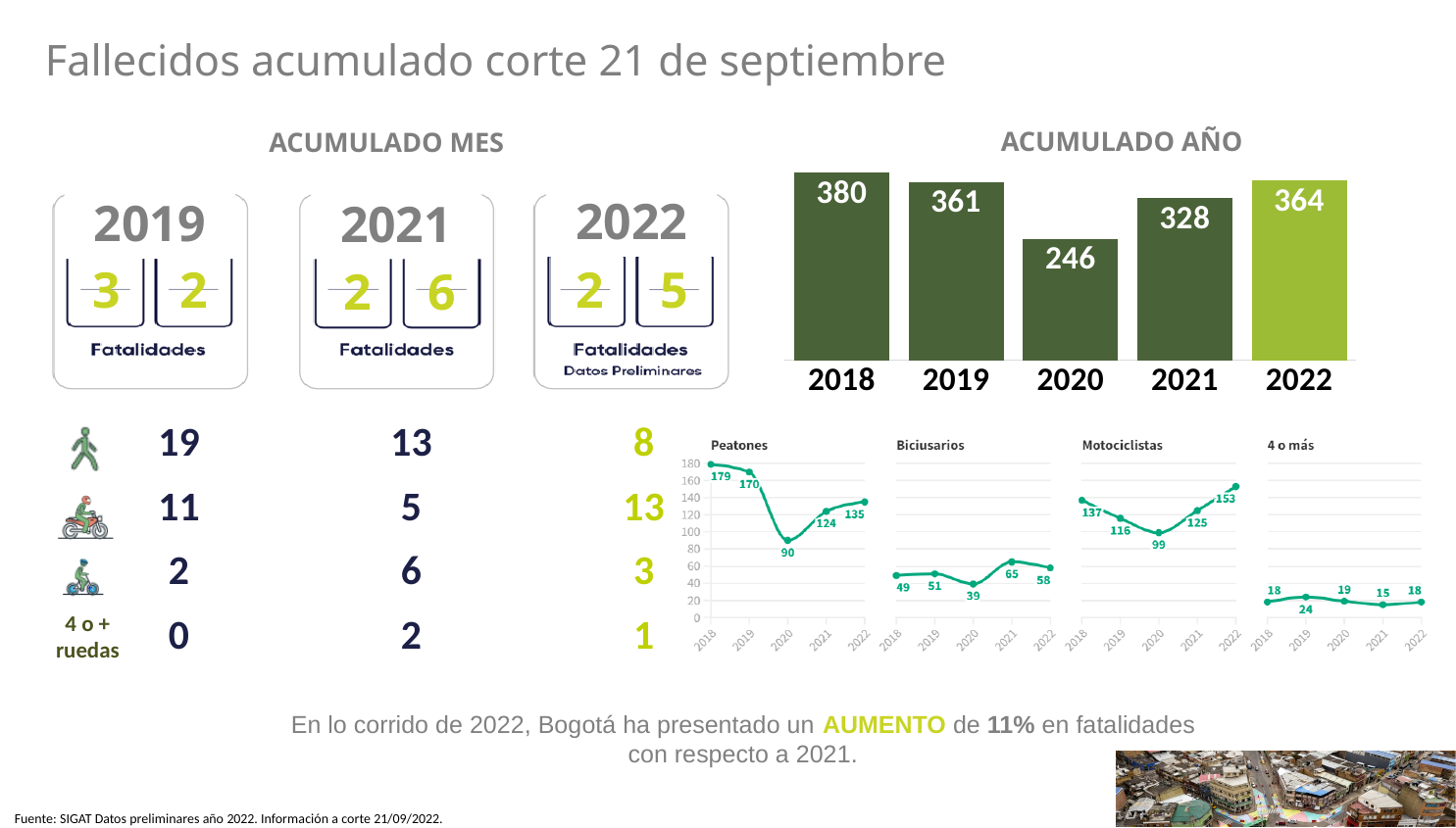
In the ACUMULADO AÑO bar chart, how many years are shown? 5 In the Motociclistas line chart, what is the difference between the values for 2022 and 2018? 16 In the ACUMULADO AÑO bar chart, what is the difference between the values for 2022 and 2021? 36 In the ACUMULADO AÑO bar chart, which year has the lowest value? 2020 In the Motociclistas line chart, which year has the lowest value? 2020 In the ACUMULADO AÑO bar chart, which year has the highest value? 2018 In the Biciusarios line chart, what is the value for 2021? 65 In the ACUMULADO AÑO bar chart, what is the value for 2020? 246 In the Peatones line chart, what is the value for 2020? 90 What kind of chart is the ACUMULADO AÑO chart? bar chart In the 4 o más line chart, which is larger, the value for 2019 or the value for 2021? 2019 In the Peatones line chart, which year has the highest value? 2018